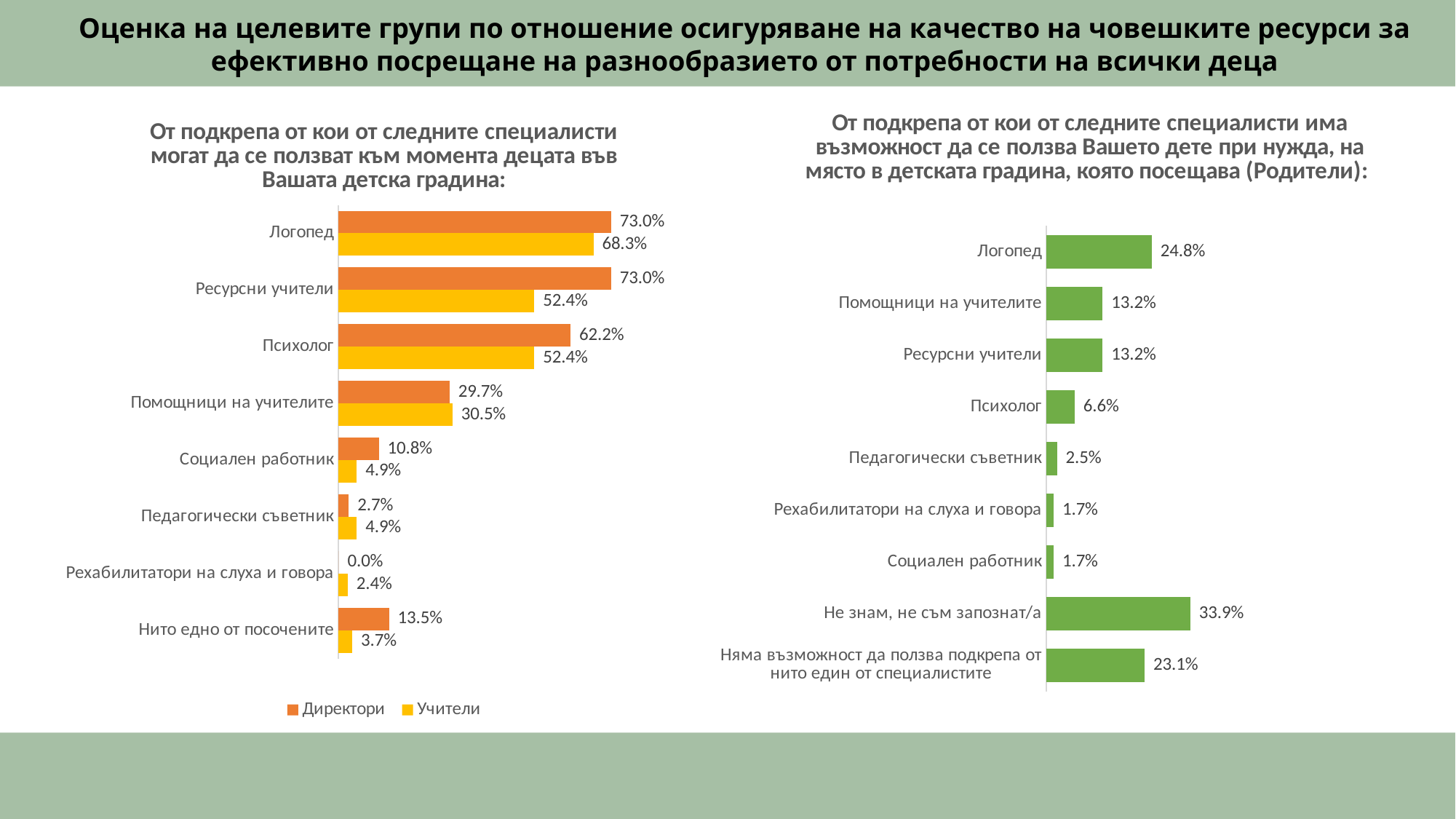
In the right chart (Родители), which category has the highest value? Не знам, не съм запознат/а In the left chart, what is the difference between the Директори and Учители values for Ресурсни учители? 20.6% In the left chart, what is the value for Директори for Психолог? 62.2% How many series does the legend of the left chart list? 2 How many categories are shown in the left chart? 8 In the left chart, what is the value for Учители for Ресурсни учители? 52.4% In the left chart, which category has the lowest value for Директори? Рехабилитатори на слуха и говора How many categories are shown in the right chart (Родители)? 9 What kind of chart is the right chart (Родители)? Bar chart In the right chart (Родители), what is the difference between Не знам, не съм запознат/а and Няма възможност да ползва подкрепа от нито един от специалистите? 10.8% In the left chart, which is larger for Помощници на учителите: the Директори value or the Учители value? Учители In the right chart (Родители), what is the value for Логопед? 24.8%